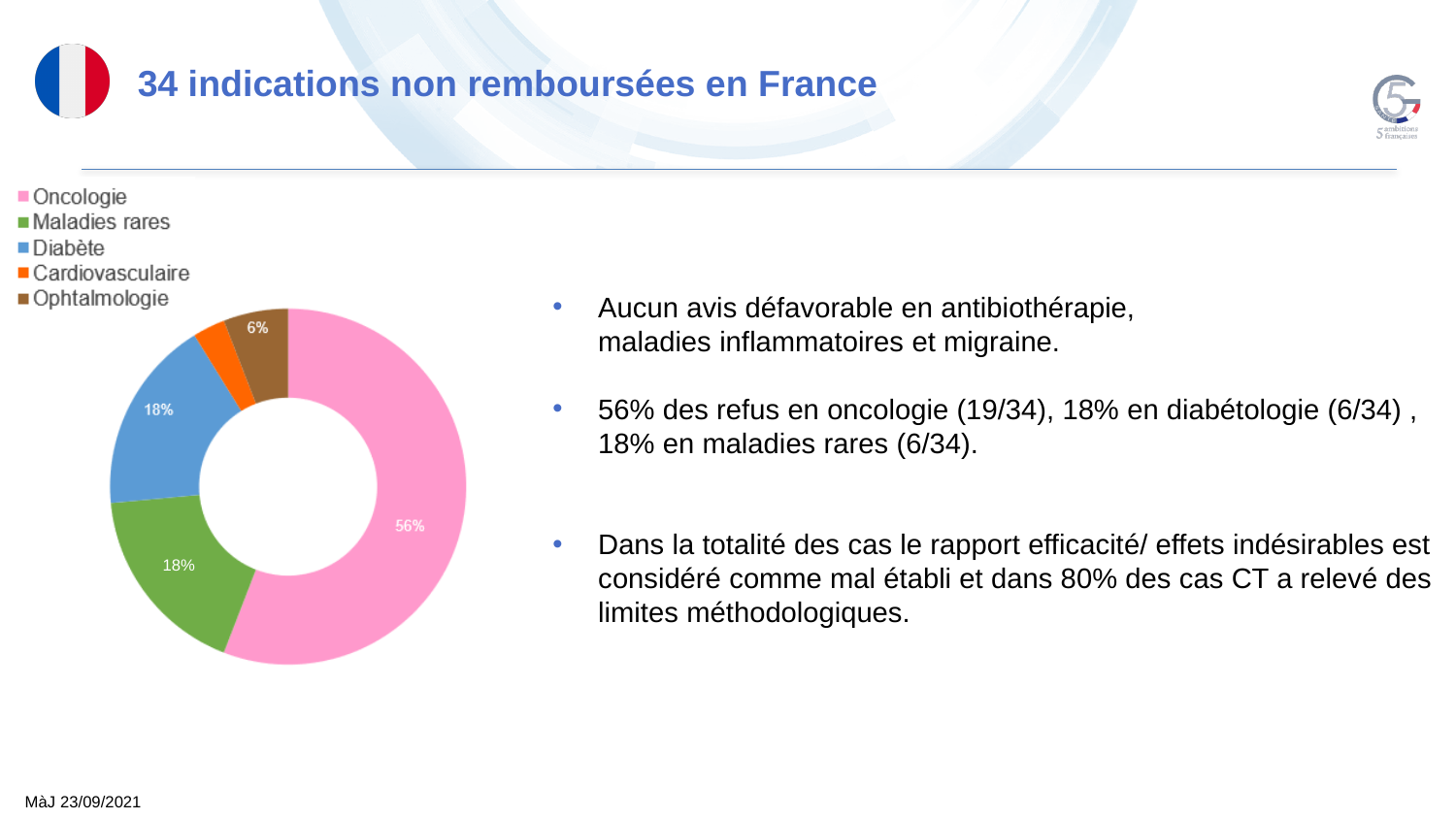
Which category has the largest slice in the chart? Oncologie Which category has the smallest slice in the chart? Cardiovasculaire What colour represents Oncologie in the chart? Pink What percentage is shown for Ophtalmologie in the chart? 6% What kind of chart is shown on the slide? Doughnut (pie) chart What colour represents Diabète in the chart? Blue What percentage does the Oncologie slice show in the doughnut chart? 56% How many categories does the chart's legend list? 5 Which is larger in the chart, the Oncologie slice or the Diabète slice? Oncologie What is the difference in percentage points between the Oncologie slice and the Ophtalmologie slice? 50 percentage points What percentage is shown for Diabète in the chart? 18% What percentage is shown for Maladies rares in the chart? 18%